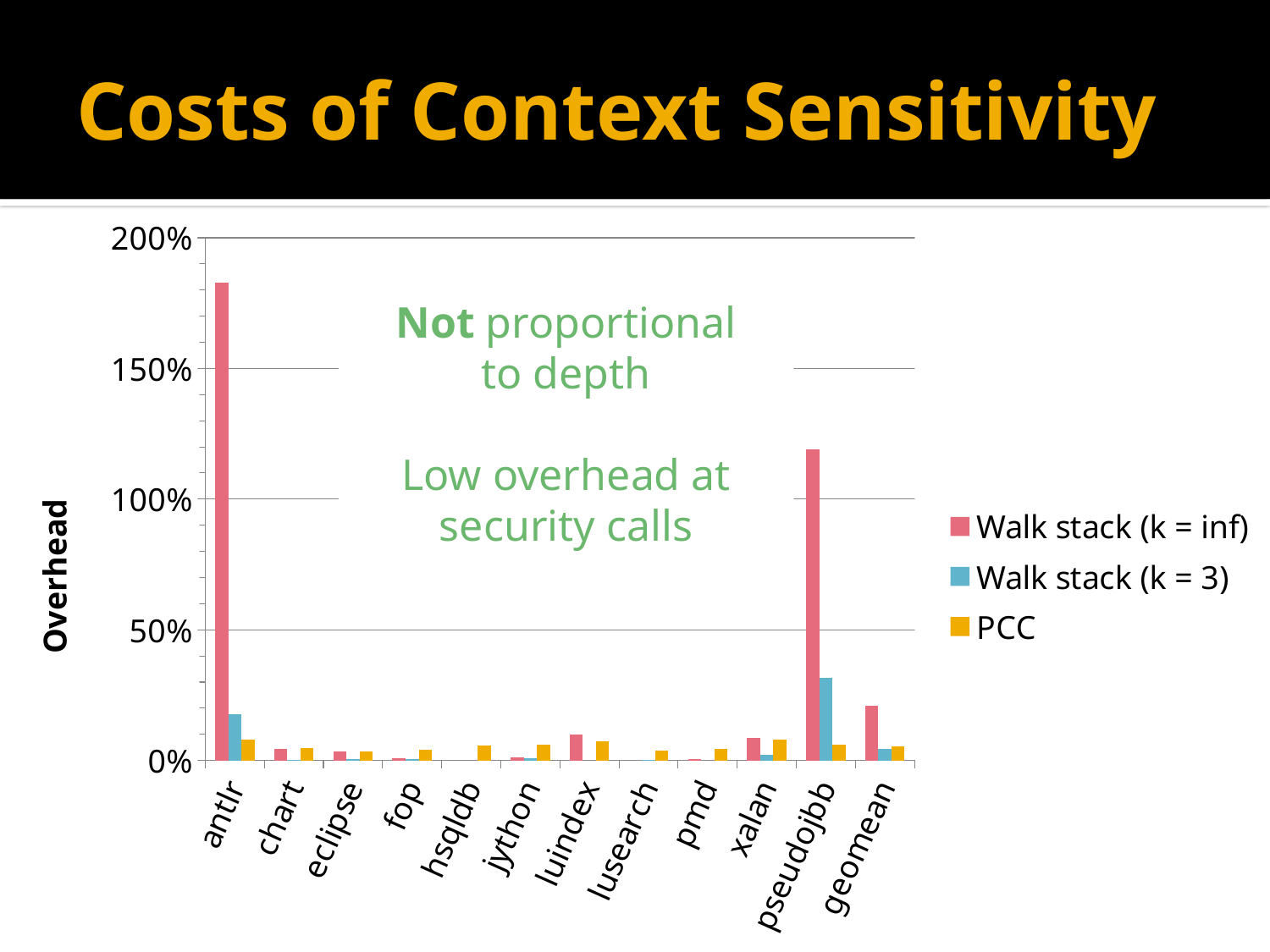
Which series is shown in yellow in the legend? PCC How many benchmark categories are shown on the x axis? 12 Is the Walk stack (k = inf) value for geomean greater or less than 50%? less Is the Walk stack (k = inf) value for antlr greater or less than 150%? greater What is the label on the vertical axis? Overhead Is the Walk stack (k = inf) value for pseudojbb greater or less than 100%? greater How many series does the legend list? 3 Which category has the highest value for the Walk stack (k = inf) series? antlr What kind of chart is shown on the slide? bar chart For pseudojbb, which series has the larger value: Walk stack (k = inf) or Walk stack (k = 3)? Walk stack (k = inf) Which is larger for the Walk stack (k = inf) series: antlr or pseudojbb? antlr